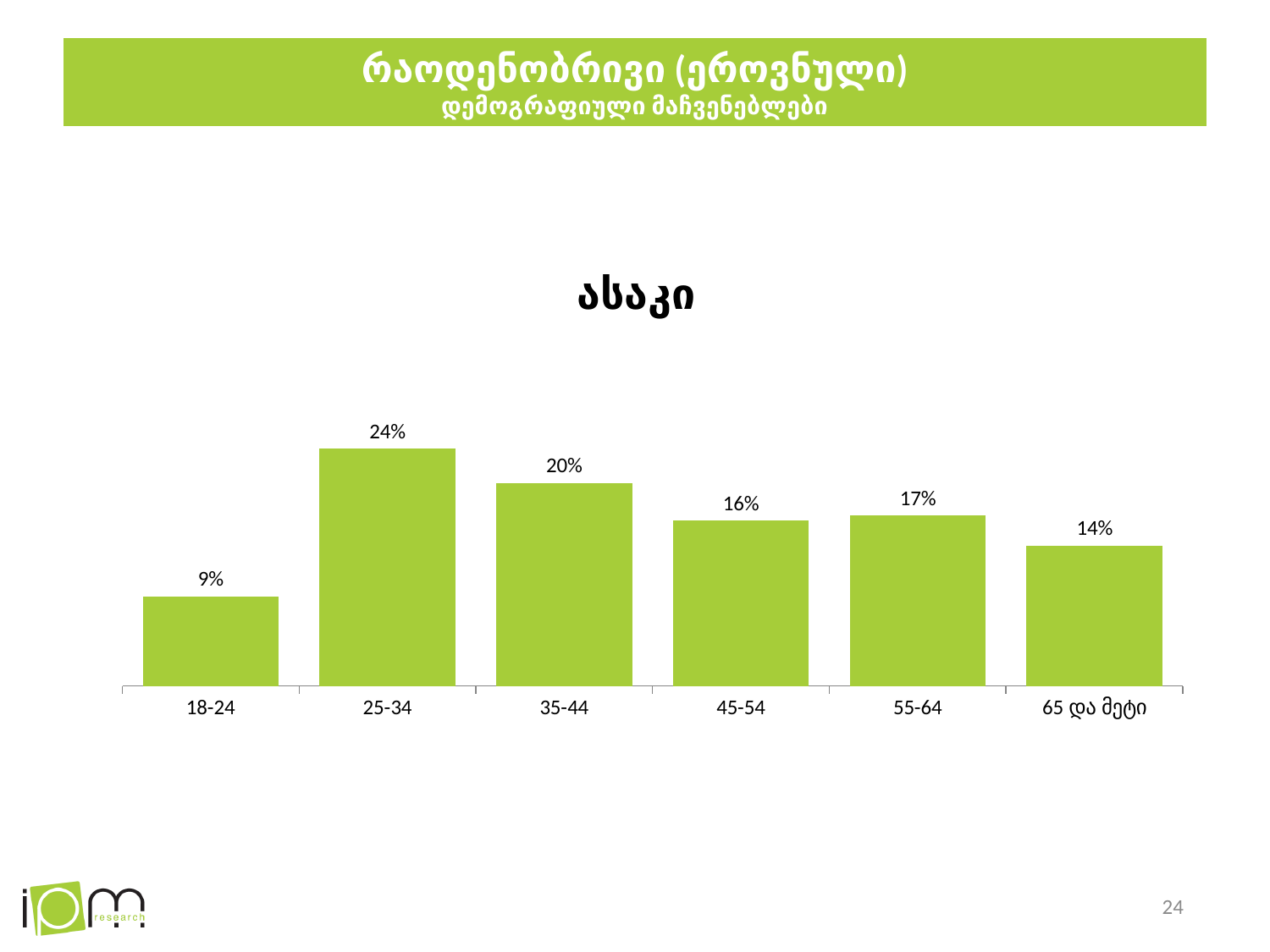
What is the value for the 18-24 age group? 9% What is the difference between the values for 55-64 and 18-24? 8% What is the title of the chart? ასაკი What kind of chart is shown on the slide? Bar chart What is the difference between the values for 25-34 and 35-44? 4% What is the value for the 65 და მეტი age group? 14% Which age group has the lowest value? 18-24 What is the value for the 45-54 age group? 16% Which age group has the highest value? 25-34 What is the value for the 25-34 age group? 24% Which is larger, the value for 35-44 or the value for 45-54? 35-44 How many age groups are shown on the chart? 6